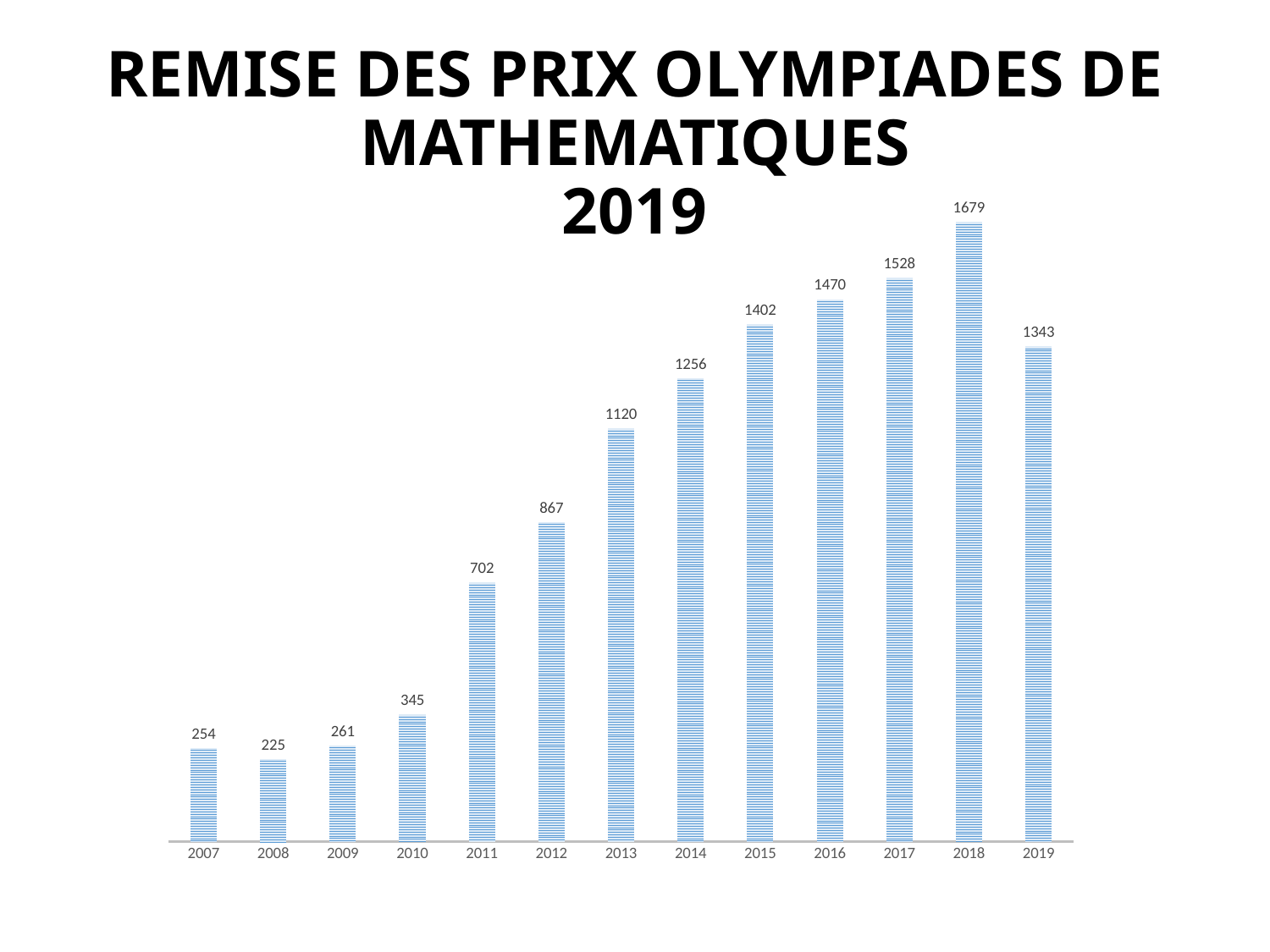
Which year has the lowest value? 2008 What kind of chart is shown on the slide? bar chart What is the value for 2013? 1120 Which year has the highest value? 2018 What is the value for 2019? 1343 What is the difference between the values for 2018 and 2019? 336 How many years are shown on the x axis? 13 What is the value for 2008? 225 What is the title of the slide? REMISE DES PRIX OLYMPIADES DE MATHEMATIQUES 2019 What is the difference between the values for 2011 and 2010? 357 Do the values generally rise or fall from 2008 to 2018? rise Which is larger, the value for 2016 or the value for 2017? 2017